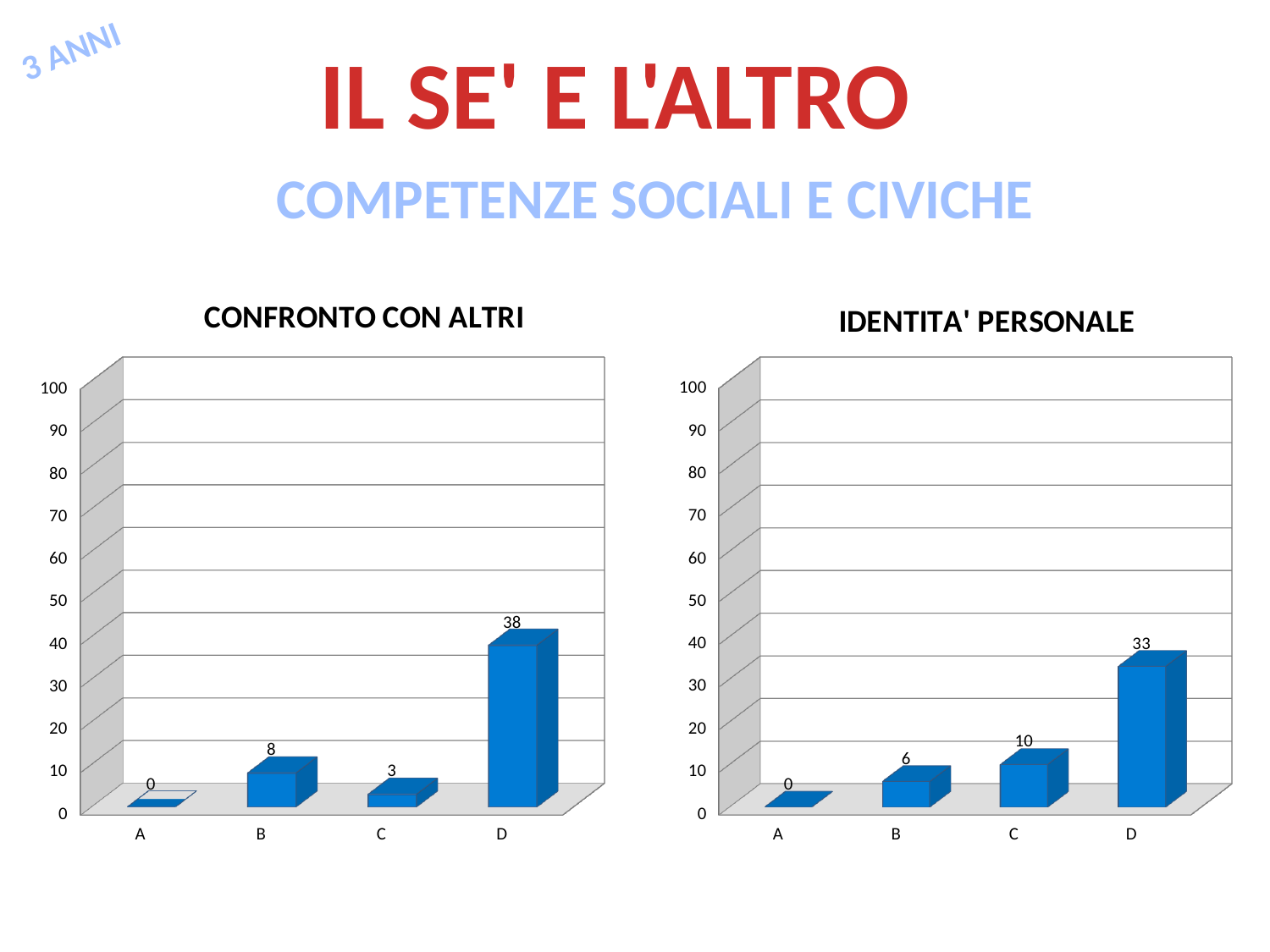
In the 'IDENTITA' PERSONALE' chart, what is the difference between the values for D and C? 23 In the 'CONFRONTO CON ALTRI' chart, what is the value for category B? 8 In the 'CONFRONTO CON ALTRI' chart, which category has the highest value? D In the 'IDENTITA' PERSONALE' chart, is the value for D greater or less than 40? less In the 'CONFRONTO CON ALTRI' chart, what is the value for category D? 38 What kind of chart is the 'IDENTITA' PERSONALE' chart? bar chart In the 'CONFRONTO CON ALTRI' chart, which is larger, the value for B or the value for C? B In the 'IDENTITA' PERSONALE' chart, what is the value for category A? 0 In the 'IDENTITA' PERSONALE' chart, what is the value for category C? 10 In the 'CONFRONTO CON ALTRI' chart, what is the difference between the values for D and B? 30 How many categories are shown in the 'CONFRONTO CON ALTRI' chart? 4 In the 'IDENTITA' PERSONALE' chart, which category has the lowest value? A